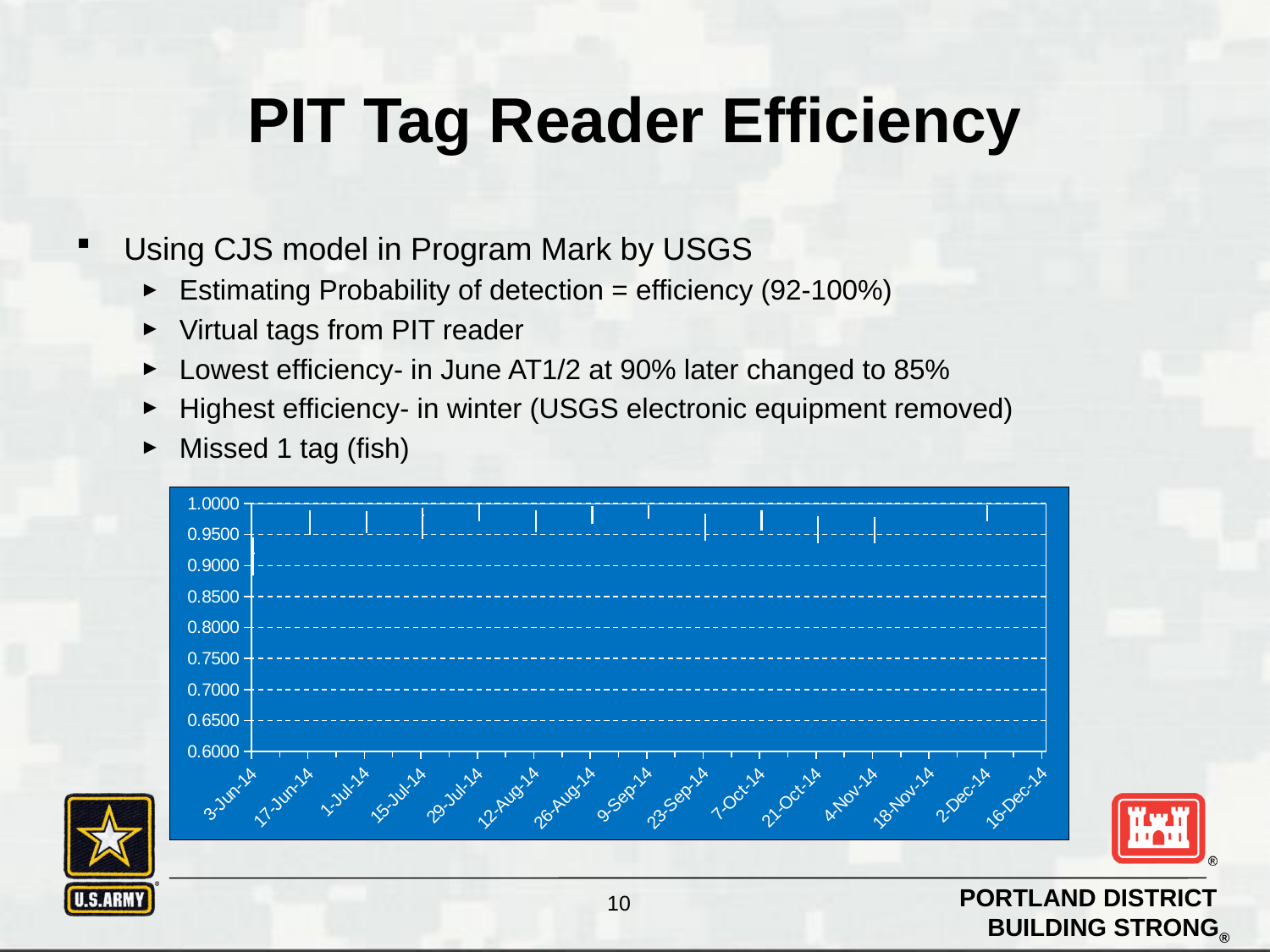
What is the last date label on the x axis of the chart? 16-Dec-14 Do the plotted values generally rise or fall from June to December along the x axis? rise How many date labels are shown along the x axis of the chart? 15 Is the value plotted near 17-Jun-14 greater or less than 0.9000? greater Is the value plotted near 16-Dec-14 greater or less than 0.9500? greater What is the highest value shown on the y axis of the chart? 1.0000 Is the value plotted at 3-Jun-14 greater or less than 0.9500? less At which date is the lowest plotted value on the chart? 3-Jun-14 What is the lowest value shown on the y axis of the chart? 0.6000 What is the first date label on the x axis of the chart? 3-Jun-14 What is the spacing between consecutive tick values on the y axis of the chart? 0.0500